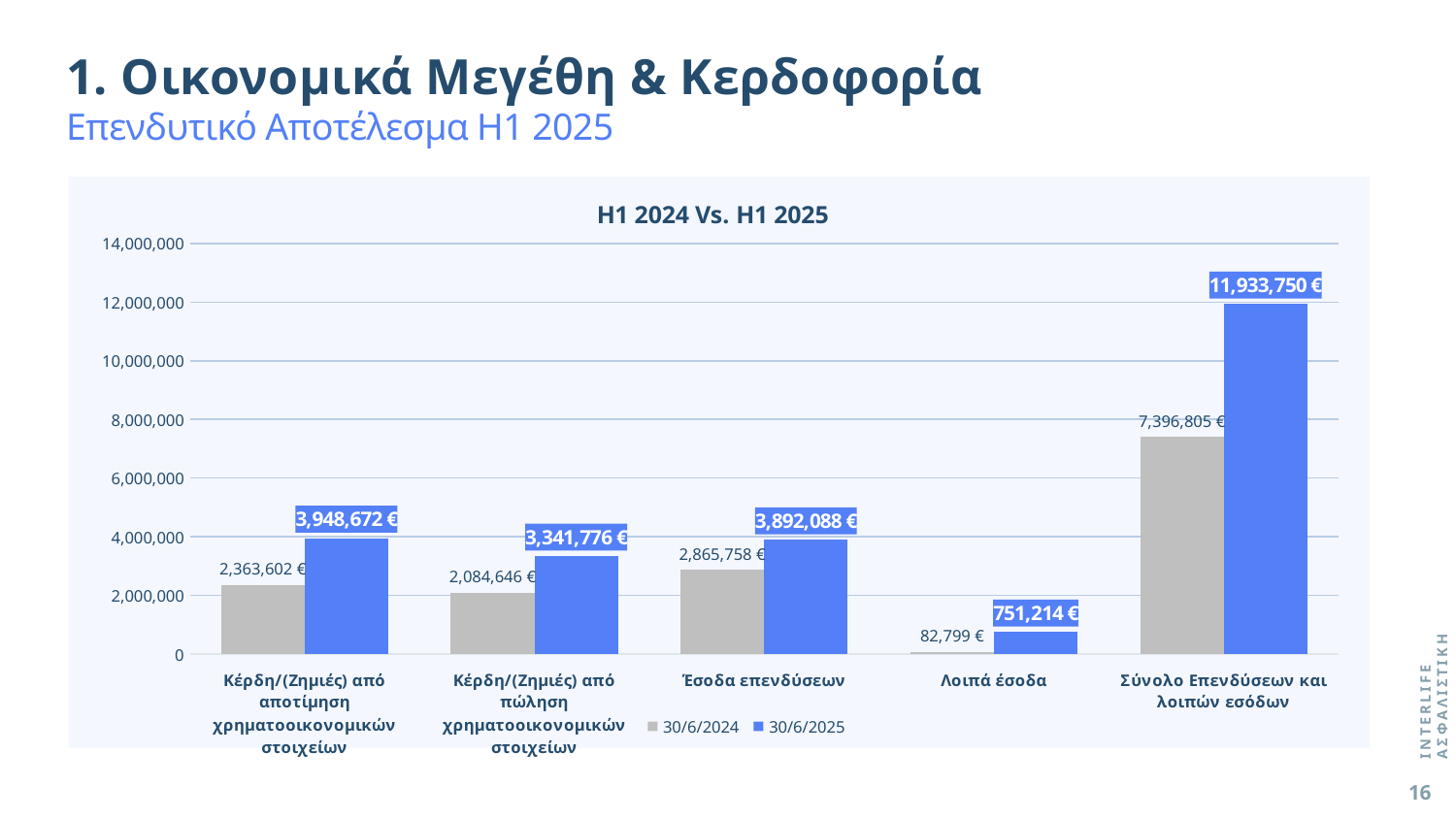
Is the 30/6/2024 value for Σύνολο Επενδύσεων και λοιπών εσόδων greater or less than 8,000,000? less What is the value for Λοιπά έσοδα in the 30/6/2024 series? 82,799 € What is the value for Έσοδα επενδύσεων in the 30/6/2025 series? 3,892,088 € Which is larger in the 30/6/2025 series: Κέρδη/(Ζημιές) από αποτίμηση χρηματοοικονομικών στοιχείων or Έσοδα επενδύσεων? Κέρδη/(Ζημιές) από αποτίμηση χρηματοοικονομικών στοιχείων What is the difference between the 30/6/2025 and 30/6/2024 values for Σύνολο Επενδύσεων και λοιπών εσόδων? 4,536,945 € What is the value for Σύνολο Επενδύσεων και λοιπών εσόδων in the 30/6/2025 series? 11,933,750 € Which category has the highest value in the 30/6/2025 series? Σύνολο Επενδύσεων και λοιπών εσόδων What is the 30/6/2024 value for Κέρδη/(Ζημιές) από πώληση χρηματοοικονομικών στοιχείων? 2,084,646 € Which category has the lowest value in the 30/6/2024 series? Λοιπά έσοδα How many series does the legend list? 2 How many categories are shown on the x axis of the chart? 5 What is the difference between the 30/6/2025 and 30/6/2024 values for Λοιπά έσοδα? 668,415 €